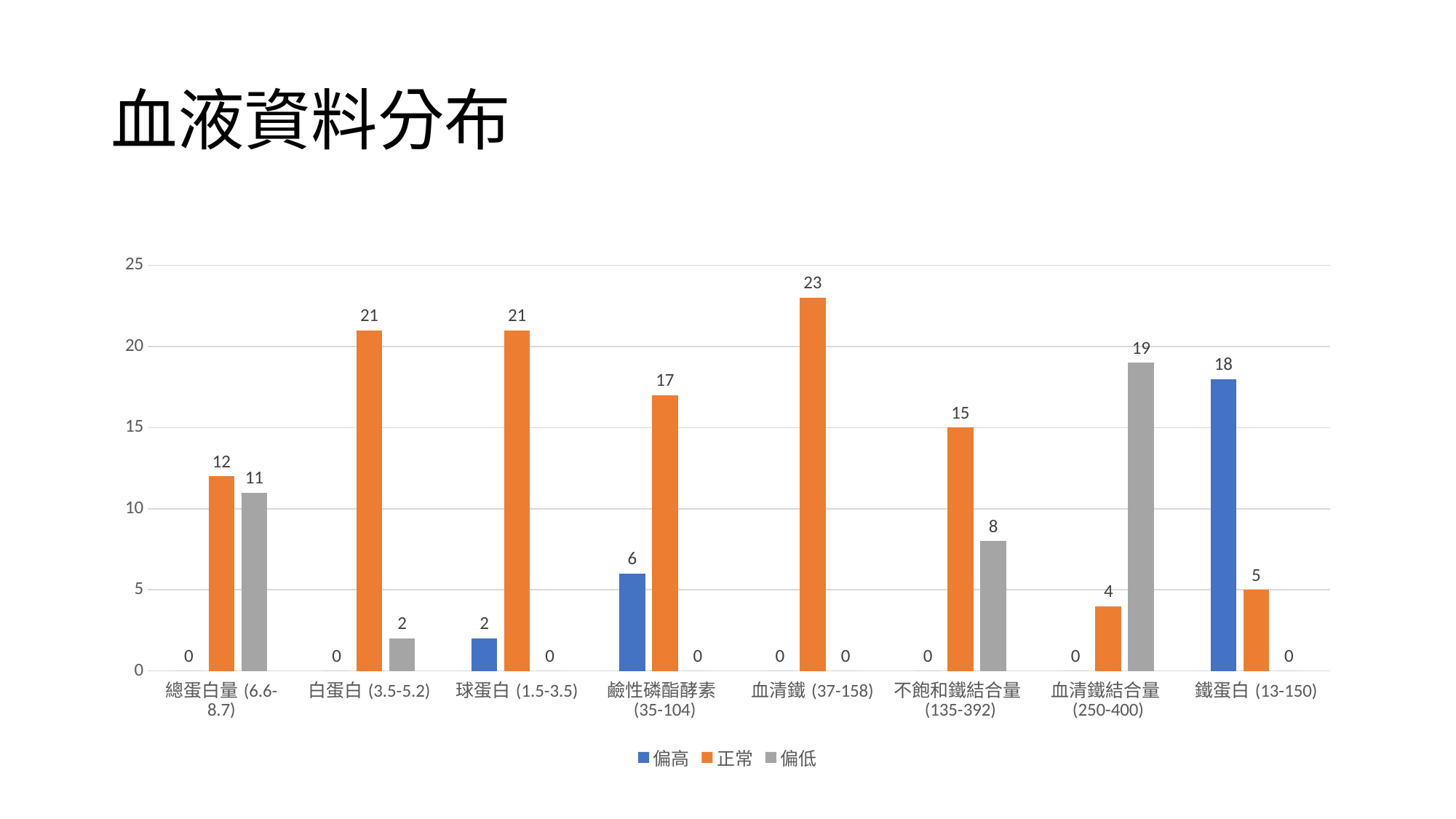
Which is larger for 不飽和鐵結合量 (135-392): the 正常 value or the 偏低 value? 正常 What kind of chart is shown on the slide? bar chart Which category has the highest 正常 value? 血清鐵 (37-158) What is the title of the slide? 血液資料分布 What is the 偏低 value for 血清鐵結合量 (250-400)? 19 Which category has the lowest 正常 value? 血清鐵結合量 (250-400) What is the difference between the 正常 and 偏低 values for 總蛋白量 (6.6-8.7)? 1 What is the 正常 value for 血清鐵 (37-158)? 23 How many categories are shown on the x axis? 8 What is the total of the three series for 鹼性磷酯酵素 (35-104)? 23 How many series does the legend list? 3 What is the 偏高 value for 鐵蛋白 (13-150)? 18